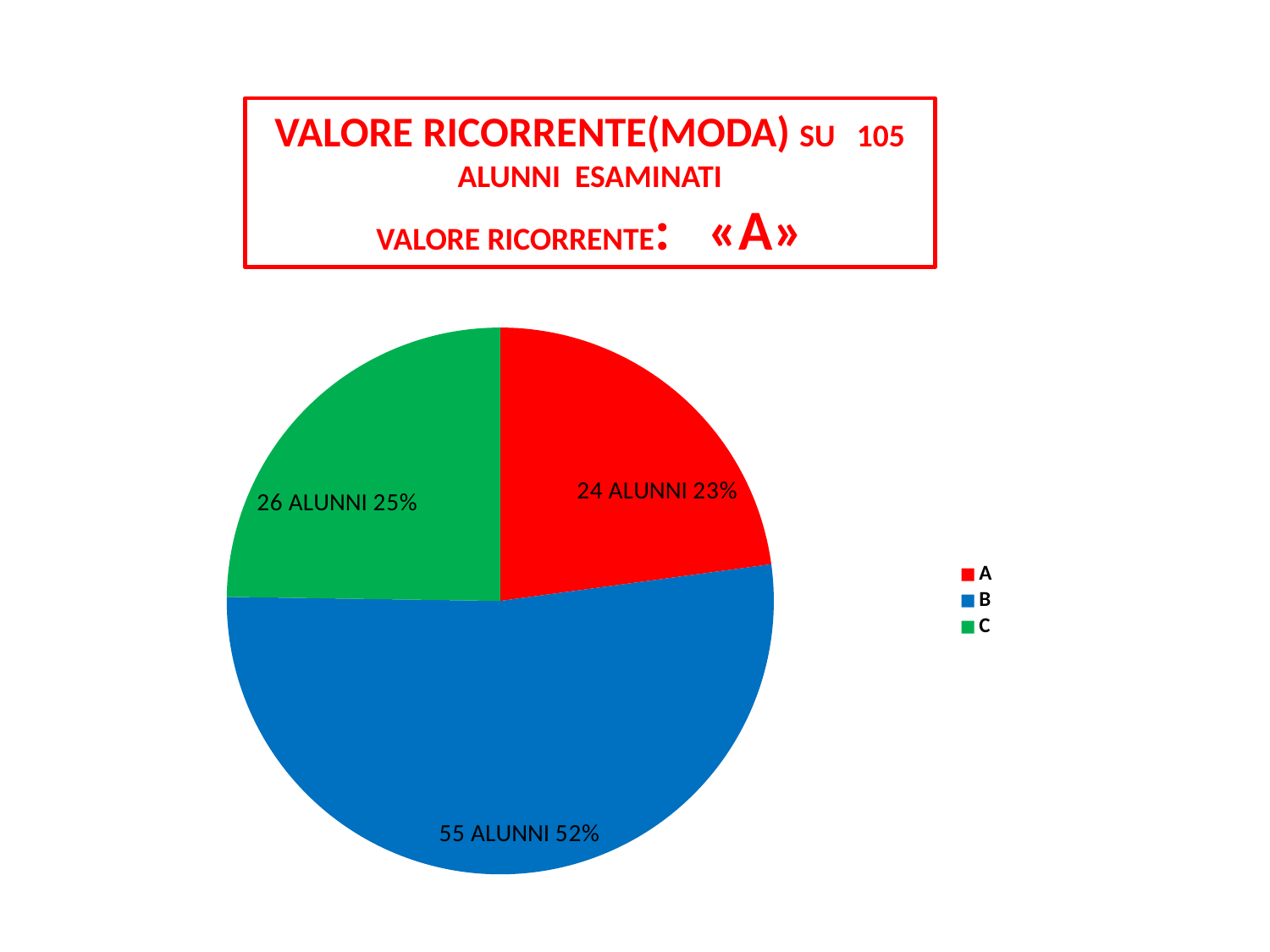
How many alunni are in slice C? 26 ALUNNI How many slices does the pie chart have? 3 Which slice is the smallest? A How many alunni are in slice A? 24 ALUNNI Which colour represents slice C in the pie chart? green What is the difference in number of alunni between slice B and slice A? 31 Which slice is the largest? B How many alunni are in slice B? 55 ALUNNI How many entries does the legend list? 3 What share of the pie does slice C represent? 25% What kind of chart is shown on the slide? pie chart What share of the pie does slice B represent? 52%